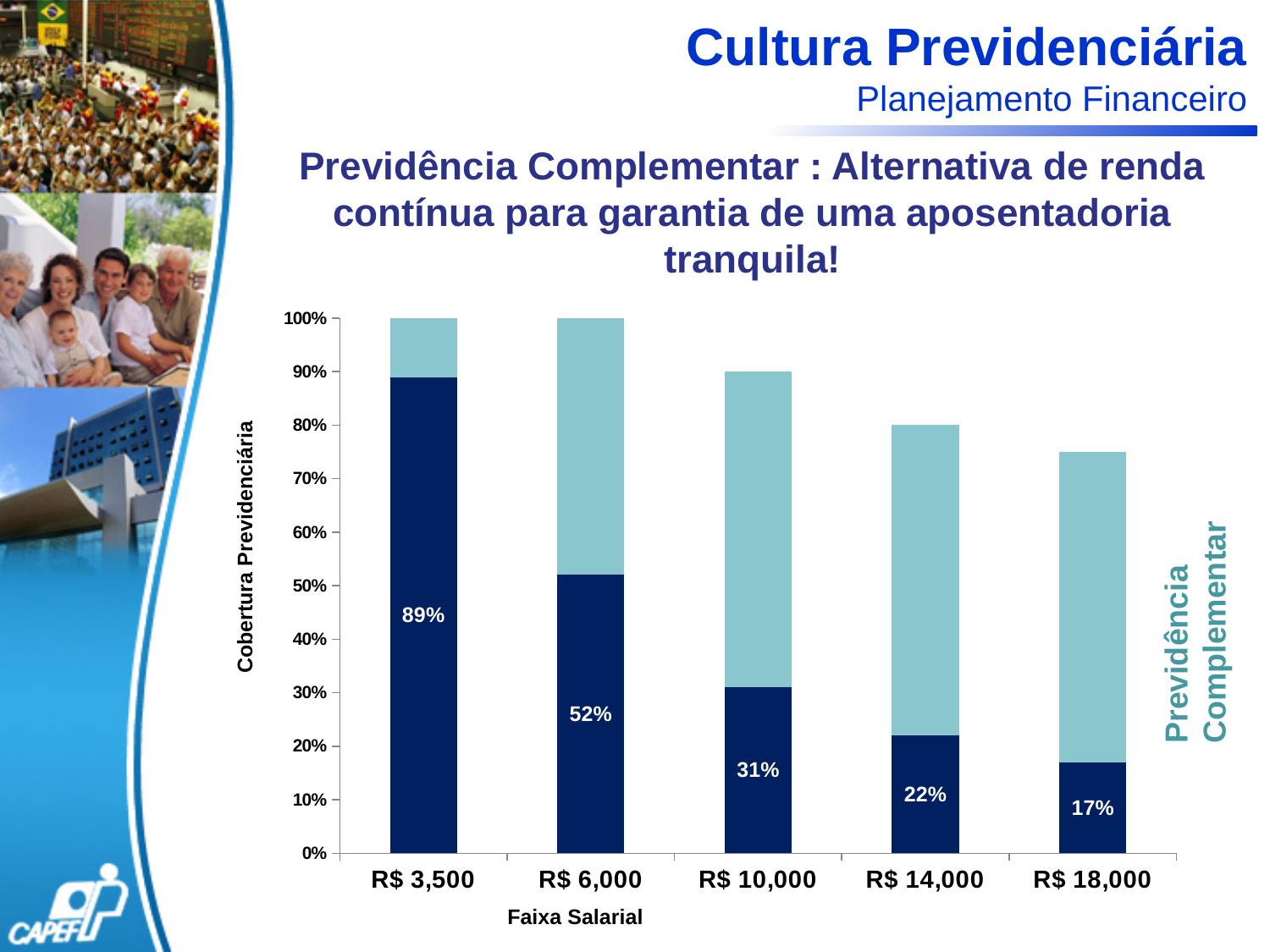
What is the dark blue value for the R$ 18,000 salary range? 17% What is the dark blue value for the R$ 3,500 salary range? 89% Do the dark blue values rise or fall as the salary range increases along the x axis? Fall What is the dark blue value for the R$ 10,000 salary range? 31% What is the title of the y axis? Cobertura Previdenciária Which salary range has the highest dark blue value? R$ 3,500 Is the light blue segment for R$ 18,000 greater or less than 50%? greater What kind of chart is shown on the slide? Stacked bar chart Which salary range has the lowest dark blue value? R$ 18,000 How many salary ranges are shown on the x axis? 5 Which has a larger dark blue value, R$ 6,000 or R$ 10,000? R$ 6,000 What is the difference between the dark blue values for R$ 6,000 and R$ 14,000? 30%